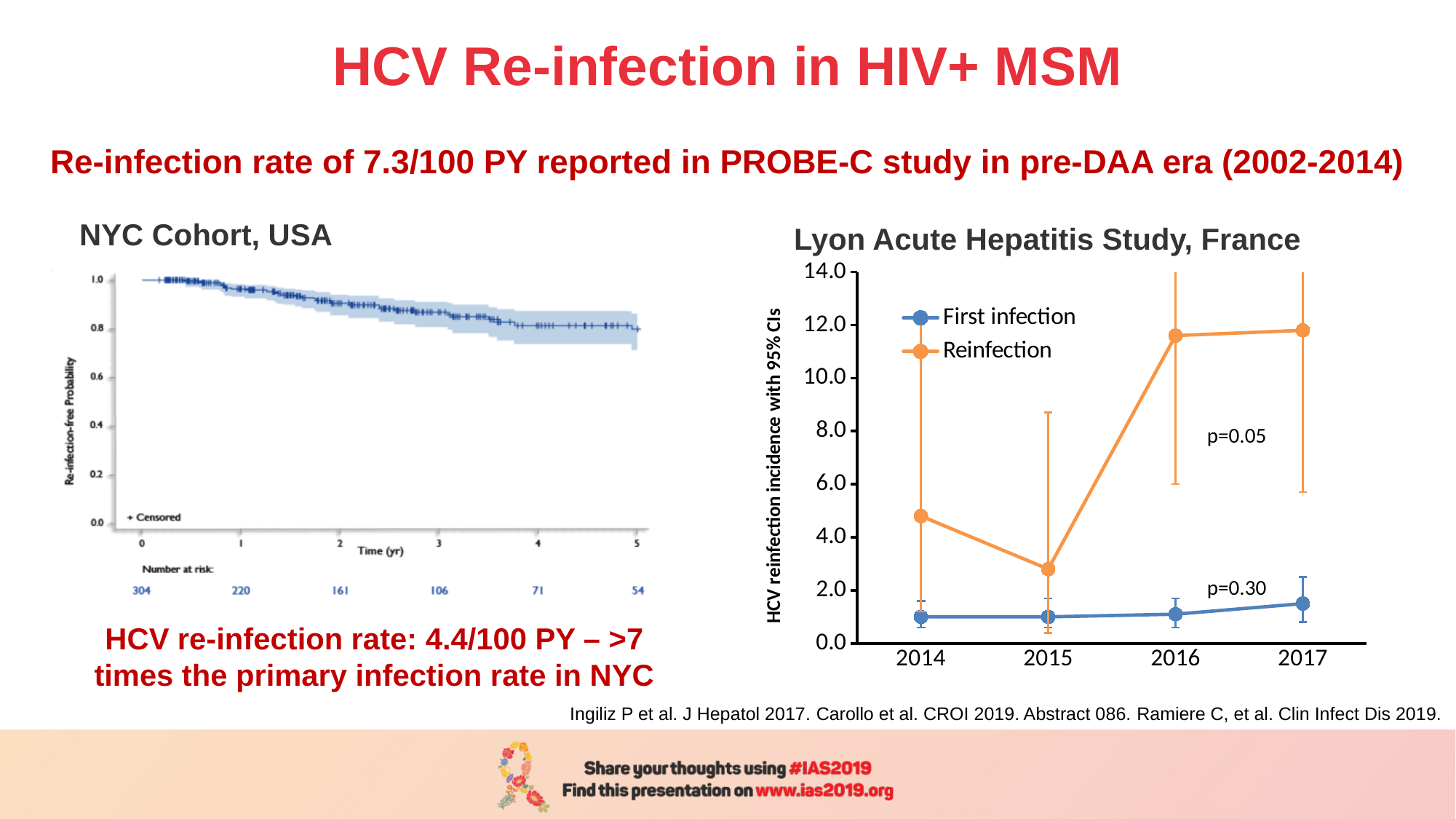
In the Lyon Acute Hepatitis Study chart, which series has the higher value in 2016, First infection or Reinfection? Reinfection In the Lyon Acute Hepatitis Study chart, is the Reinfection value for 2016 greater or less than 10.0? greater In the Lyon Acute Hepatitis Study chart, is the Reinfection value for 2015 greater or less than 4.0? less In the Lyon Acute Hepatitis Study chart, how many series does the legend list? 2 In the Lyon Acute Hepatitis Study chart, what p-value is printed next to the First infection series? p=0.30 In the Lyon Acute Hepatitis Study chart, how many years are shown on the x axis? 4 In the NYC Cohort chart, what is the number at risk at 5 years? 54 In the NYC Cohort chart, what is the number at risk at time 0? 304 In the Lyon Acute Hepatitis Study chart, in which year is the Reinfection value lowest? 2015 In the Lyon Acute Hepatitis Study chart, what are the two series named in the legend? First infection and Reinfection In the Lyon Acute Hepatitis Study chart, is the First infection value for 2017 greater or less than 2.0? less In the Lyon Acute Hepatitis Study chart, does the Reinfection series rise or fall between 2015 and 2016? rise